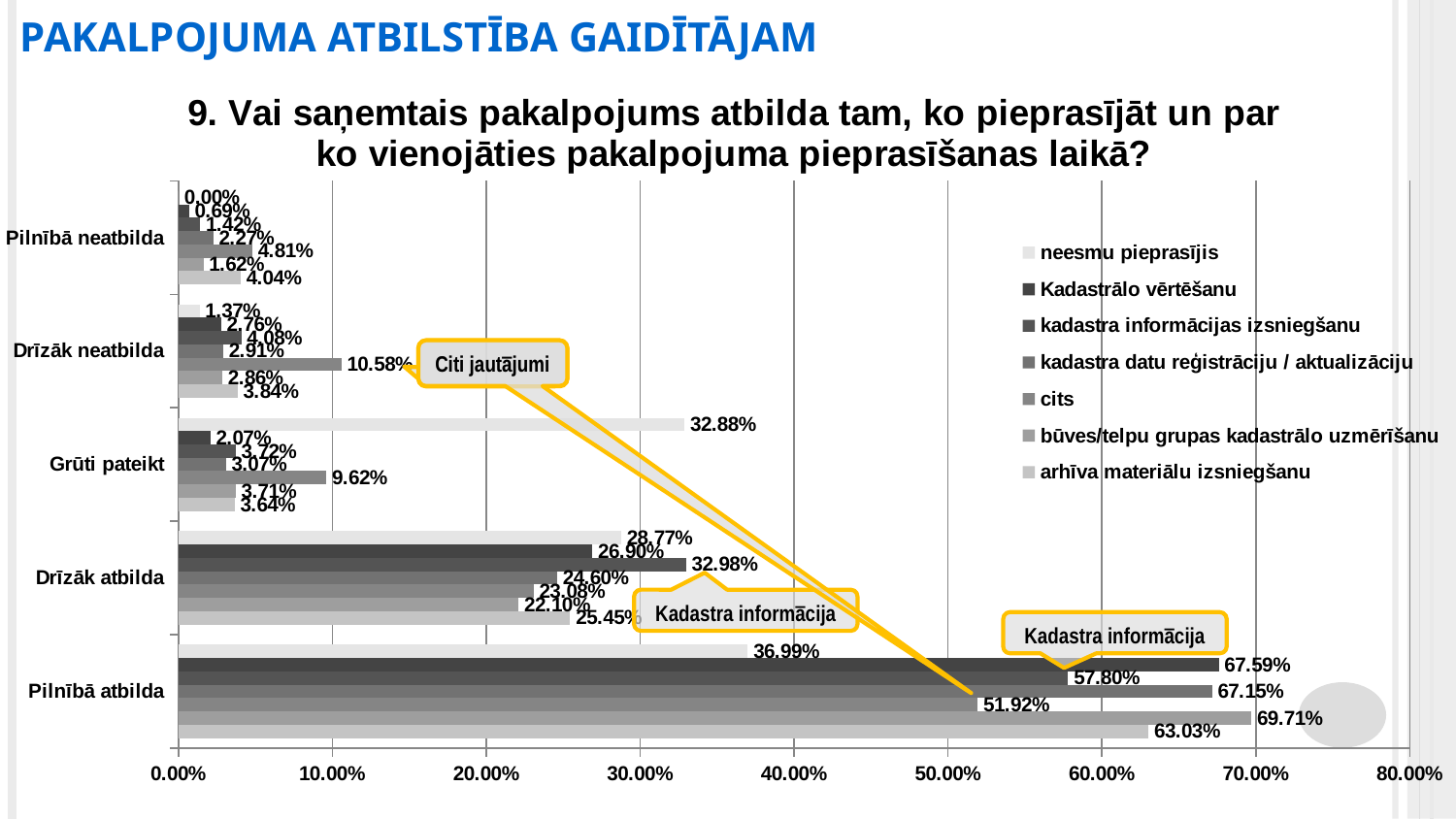
How many response categories are shown on the vertical axis of the chart? 5 What is the maximum value shown on the horizontal axis of the chart? 80.00% What is the value for 'cits' in the 'Drīzāk neatbilda' category? 10.58% How many series does the chart legend list? 7 What is the value for 'neesmu pieprasījis' in the 'Pilnībā atbilda' category? 36.99% What is the difference between the highest value in 'Pilnībā atbilda' (69.71%) and the 'neesmu pieprasījis' value in that group (36.99%)? 32.72% What is the value for 'cits' in the 'Grūti pateikt' category? 9.62% What type of chart is shown on the slide? bar chart What is the highest value shown in the 'Pilnībā atbilda' group? 69.71% Is the largest value in the 'Drīzāk atbilda' group greater or less than 40%? less What is the value for 'neesmu pieprasījis' in the 'Grūti pateikt' category? 32.88% Which is larger: the 'neesmu pieprasījis' value for 'Pilnībā atbilda' or for 'Grūti pateikt'? Pilnībā atbilda